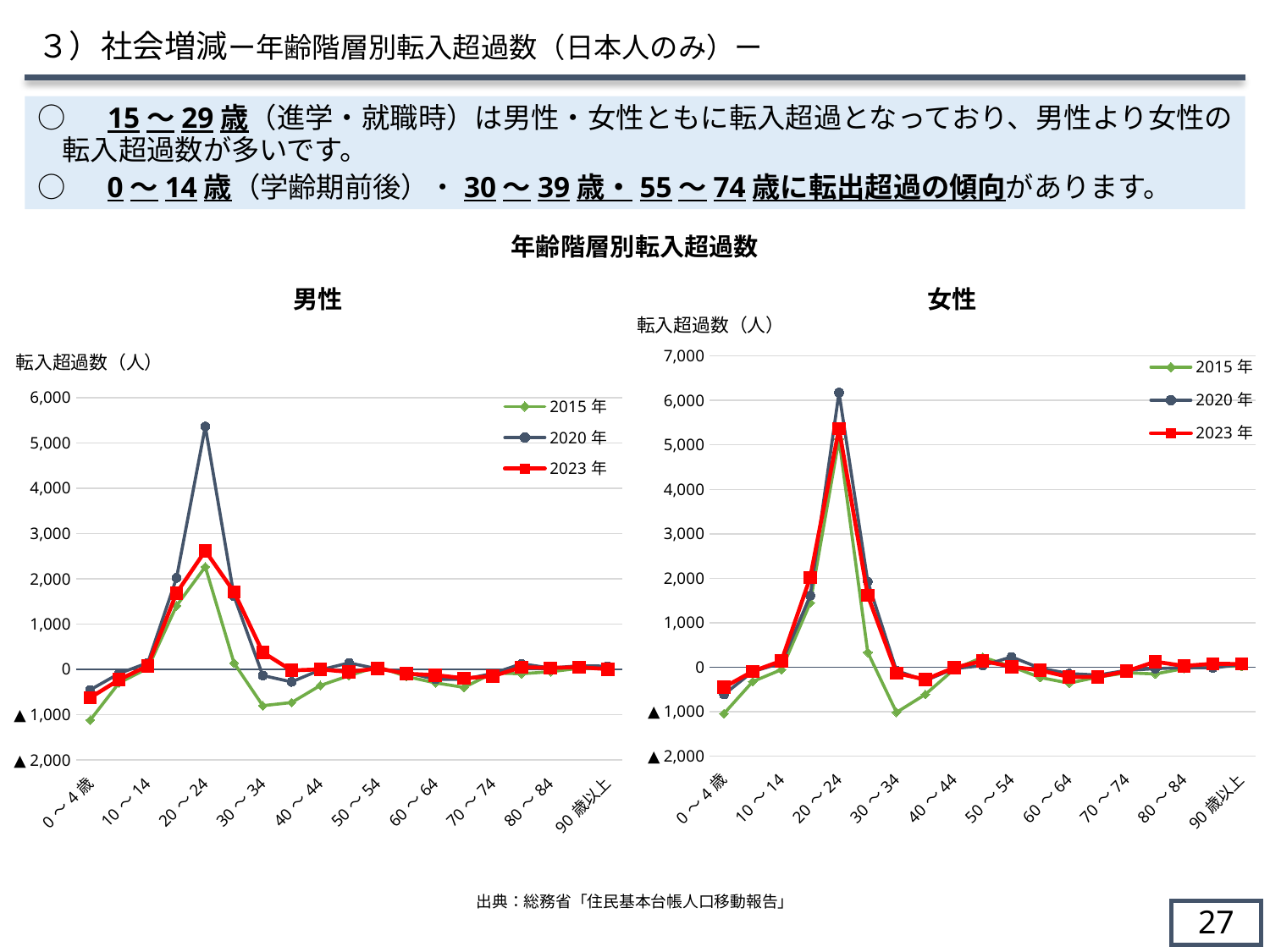
In the 男性 chart, is the 2023年 value for 20～24 greater or less than 2,000? greater What are the legend entries of the 男性 chart? 2015年, 2020年, 2023年 In the 男性 chart, is the 2020年 value for 20～24 greater or less than 5,000? greater In the 女性 chart, at 20～24, which series has the larger value, 2020年 or 2015年? 2020年 In the 女性 chart, is the 2020年 value for 20～24 greater or less than 6,000? greater In the 女性 chart, which age group has the highest value for the 2023年 series? 20～24 How many series does the legend of the 女性 chart list? 3 In the 男性 chart, does the 2020年 series rise or fall from 20～24 to 30～34? fall In the 男性 chart, which age group has the lowest value for the 2015年 series? 0～4歳 What kind of chart is the 男性 chart? line chart In the 男性 chart, which age group has the highest value for the 2020年 series? 20～24 In the 男性 chart, at 20～24, which series has the larger value, 2020年 or 2023年? 2020年